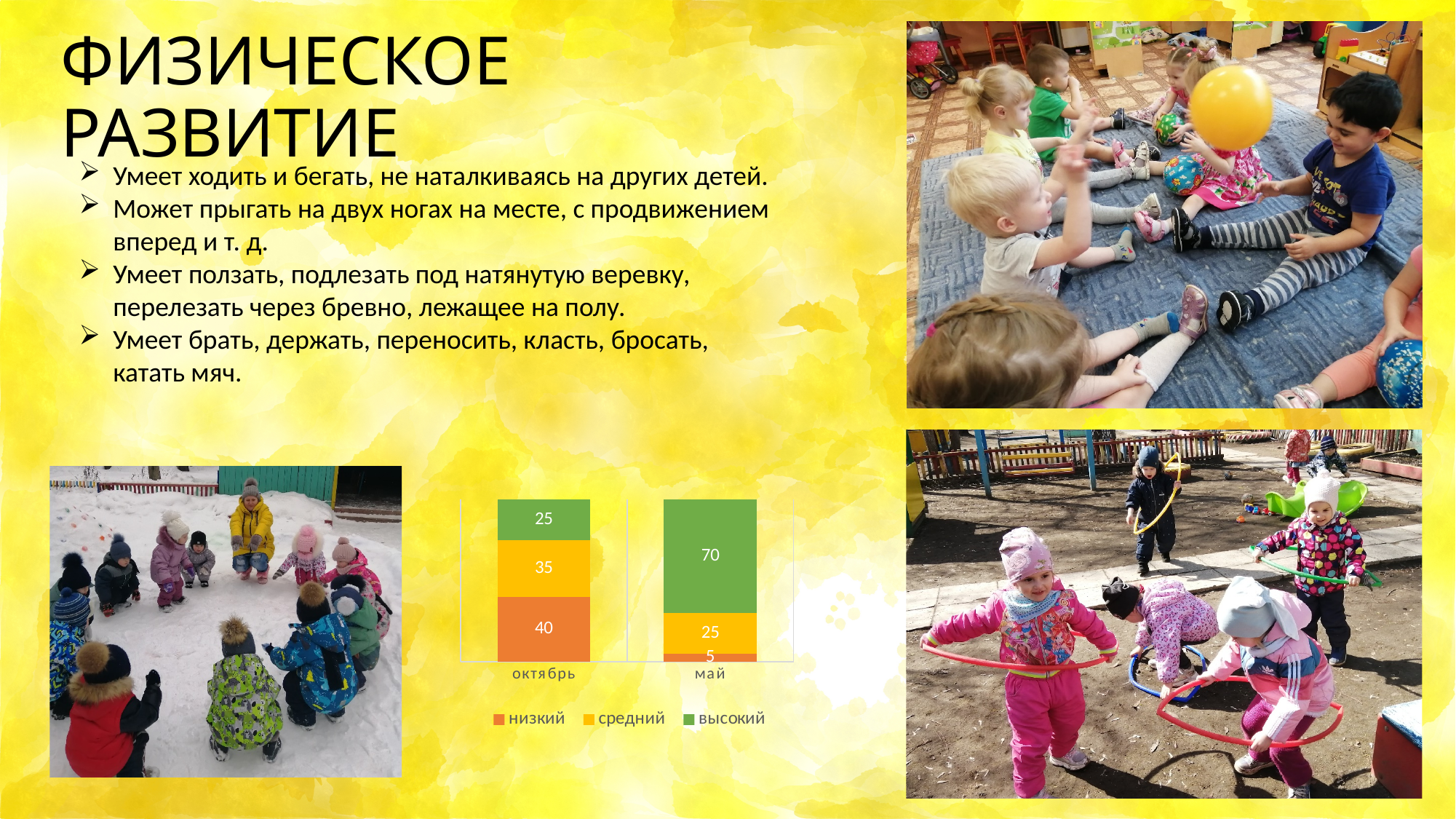
What is the difference between the высокий values for май and октябрь? 45 Does the value of низкий rise or fall from октябрь to май? fall What kind of chart is shown on the slide? stacked bar chart How many categories are shown on the x axis of the chart? 2 What is the value of низкий for май? 5 How many series does the chart legend list? 3 What is the value of высокий for май? 70 What is the total of the stacked bar for октябрь? 100 What is the value of средний for май? 25 Which category has the higher value for высокий, октябрь or май? май Which colour represents the series средний in the chart legend? yellow What is the value of низкий for октябрь? 40